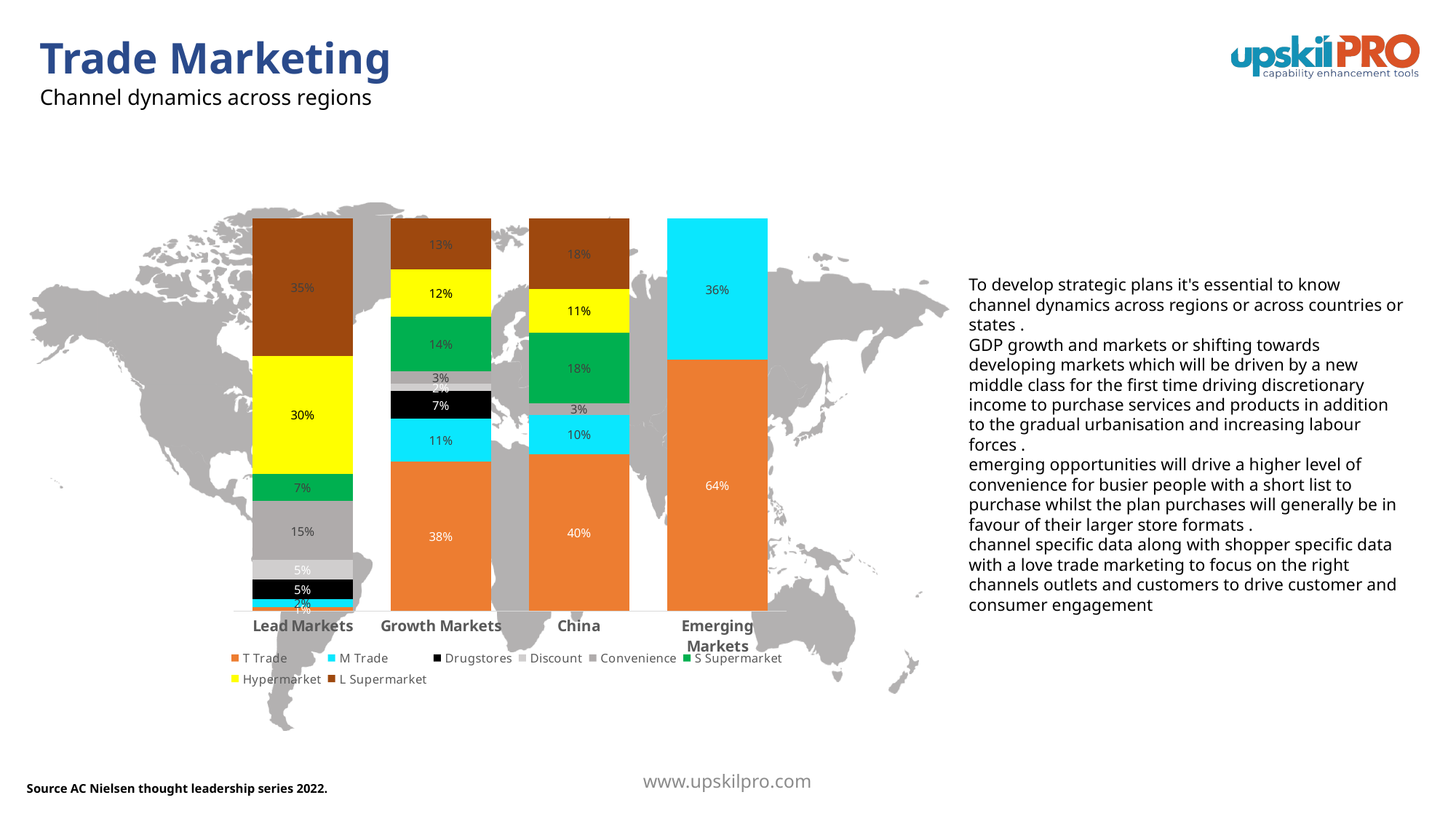
How many series does the legend list? 8 What is the difference between the M Trade share for Emerging Markets and for China? 26% What is the S Supermarket share for China? 18% How many market categories are shown along the x axis? 4 Which market has the lowest T Trade share? Lead Markets Which market has the highest T Trade share? Emerging Markets Which is larger, the L Supermarket share for Lead Markets or for China? Lead Markets What is the T Trade share for Emerging Markets? 64% What type of chart is shown on the slide? Stacked bar chart What is the total of the two segments in the Emerging Markets bar? 100% What is the Hypermarket share for Lead Markets? 30% What is the L Supermarket share for Growth Markets? 13%